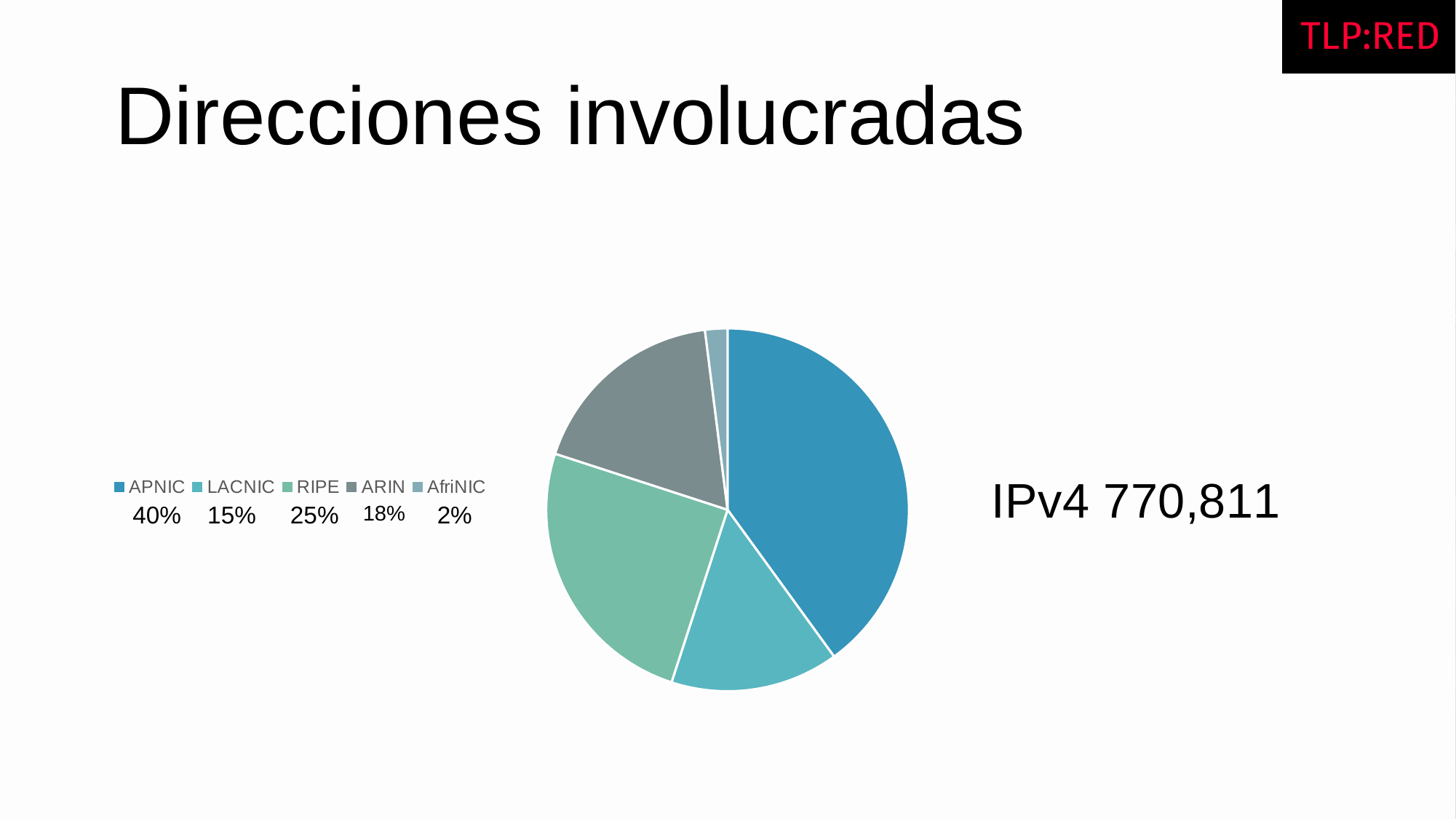
What share of the pie does ARIN have? 18% Which category has the largest slice of the pie? APNIC What share of the pie does AfriNIC have? 2% What share of the pie does APNIC have? 40% What kind of chart is shown on the slide? pie chart Which category has the smallest slice of the pie? AfriNIC What total number of IPv4 addresses is stated next to the pie chart? 770,811 What is the difference in percentage points between the APNIC and RIPE shares? 15 How many categories does the legend list? 5 Which has a larger share, ARIN or LACNIC? ARIN